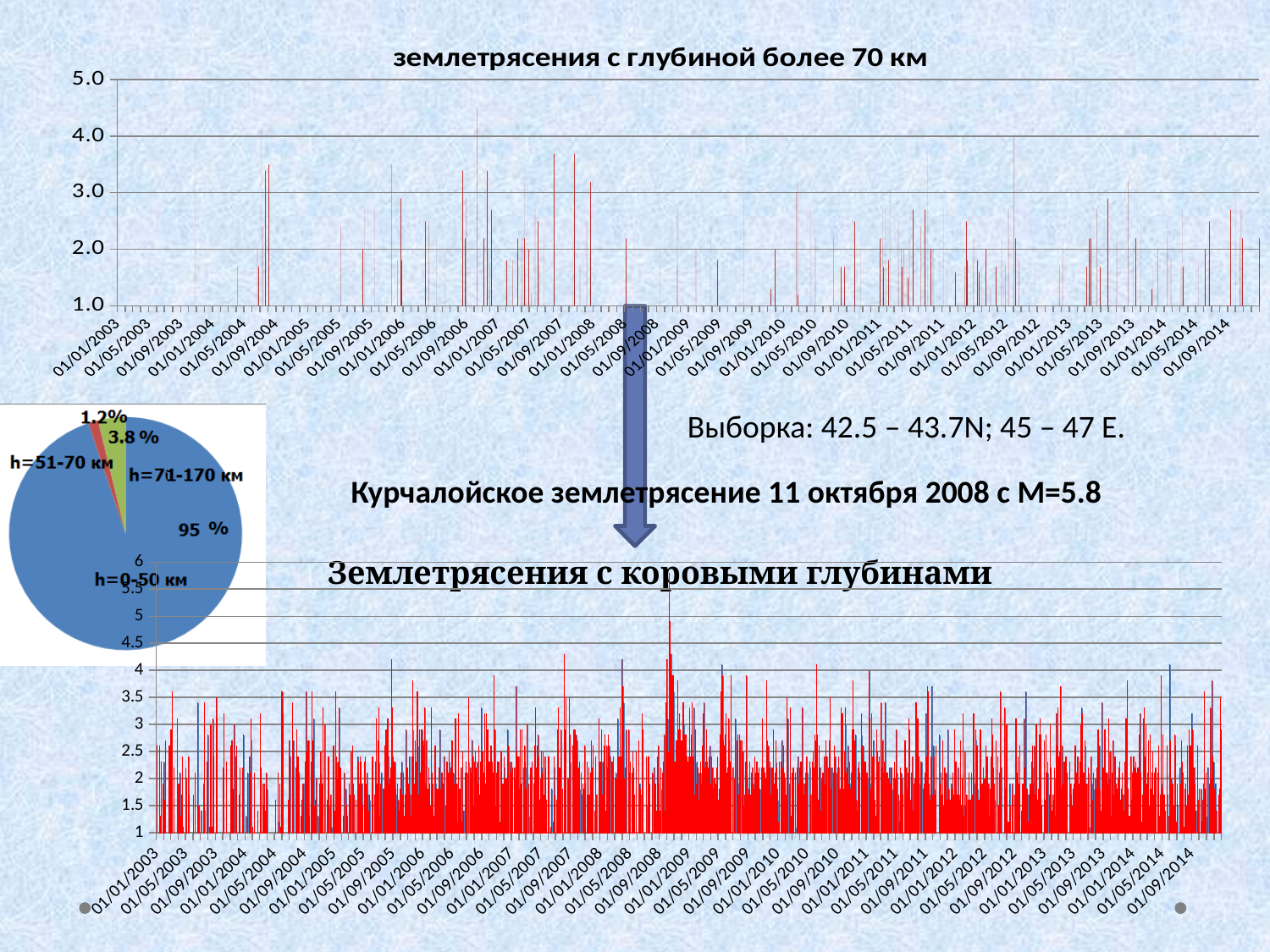
How many slices does the pie chart have? 3 What is the highest tick value on the y axis of the top chart? 5.0 What is the title of the top chart on the slide? землетрясения с глубиной более 70 км What kind of chart is the one at the bottom left of the slide showing depth categories? pie chart What is the title of the bottom chart on the slide? Землетрясения с коровыми глубинами In the pie chart, what share is shown for h=51-70 км? 1.2% In the pie chart, which depth category has the largest slice? h=0-50 км In the pie chart, what share is shown for h=71-170 км? 3.8 % In the pie chart, which slice is larger: h=71-170 км or h=51-70 км? h=71-170 км In the pie chart, which depth category has the smallest slice? h=51-70 км In the pie chart, what share is shown for h=0-50 км? 95 % What kind of chart is the top chart titled 'землетрясения с глубиной более 70 км'? bar chart